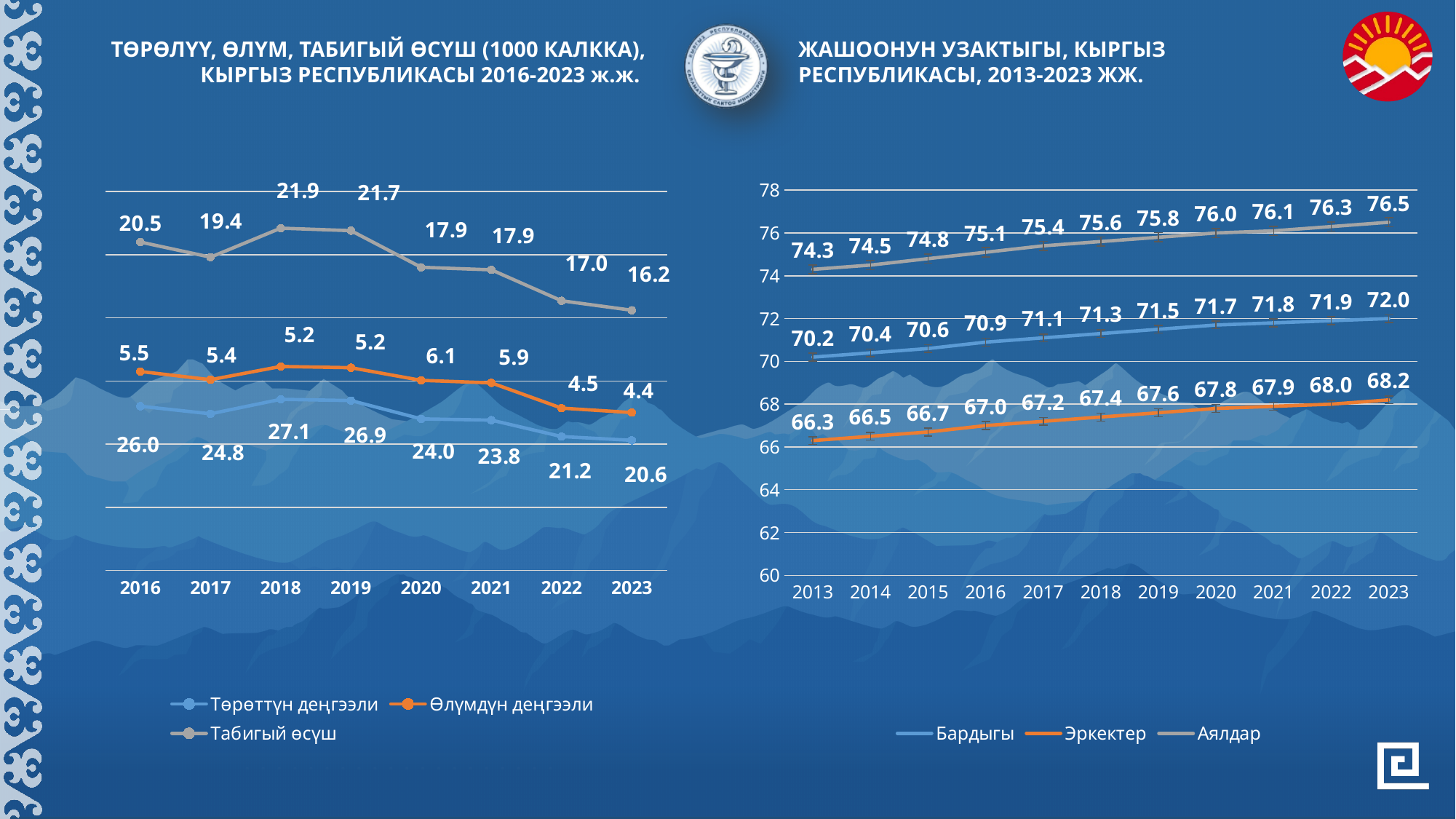
In the left chart (Төрөлүү, өлүм, табигый өсүш), in which year is Төрөттүн деңгээли lowest? 2023 In the left chart (Төрөлүү, өлүм, табигый өсүш), what kind of chart is it? Line chart In the right chart (Жашоонун узактыгы), what is the difference between Аялдар and Эркектер in 2023? 8.3 In the right chart (Жашоонун узактыгы), how many years are shown on the x axis? 11 In the right chart (Жашоонун узактыгы), what is the value of Аялдар in 2019? 75.8 In the left chart (Төрөлүү, өлүм, табигый өсүш), what is the difference between Табигый өсүш in 2016 and in 2023? 4.3 In the right chart (Жашоонун узактыгы), does the Бардыгы series rise or fall from 2013 to 2023? Rises In the left chart (Төрөлүү, өлүм, табигый өсүш), what is the value of Өлүмдүн деңгээли in 2020? 6.1 In the left chart (Төрөлүү, өлүм, табигый өсүш), what is the value of Төрөттүн деңгээли in 2018? 27.1 In the left chart (Төрөлүү, өлүм, табигый өсүш), how many series does the legend list? 3 In the right chart (Жашоонун узактыгы), what is the value of Эркектер in 2013? 66.3 In the left chart (Төрөлүү, өлүм, табигый өсүш), in which year is Табигый өсүш highest? 2018